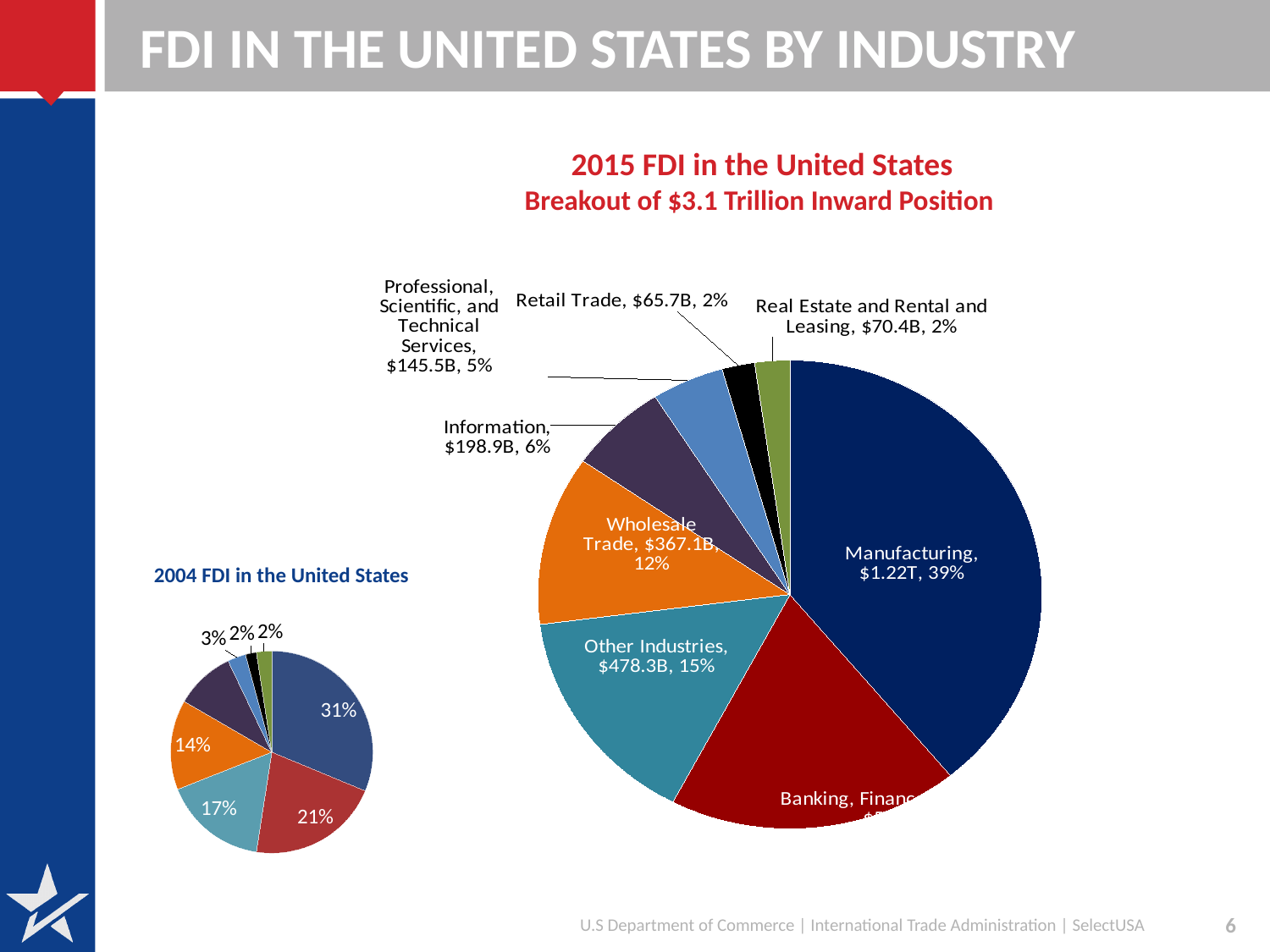
In the 2015 FDI in the United States chart, what is the value for Manufacturing? $1.22T, 39% In the 2015 FDI in the United States chart, what is the difference in value between Other Industries and Wholesale Trade? $111.2B What kind of chart is the 2004 FDI in the United States chart? Pie chart In the 2015 FDI in the United States chart, what is the value for Wholesale Trade? $367.1B In the 2015 FDI in the United States chart, how many industry slices are shown? 8 What is the subtitle of the 2015 FDI in the United States chart? Breakout of $3.1 Trillion Inward Position In the 2015 FDI in the United States chart, what share of the pie is Professional, Scientific, and Technical Services? 5% In the 2004 FDI in the United States chart, what is the largest share shown? 31% In the 2015 FDI in the United States chart, what is the value for Information? $198.9B In the 2015 FDI in the United States chart, which industry has the largest slice? Manufacturing In the 2015 FDI in the United States chart, which is larger, Retail Trade or Real Estate and Rental and Leasing? Real Estate and Rental and Leasing In the 2015 FDI in the United States chart, what share of the pie is Other Industries? 15%